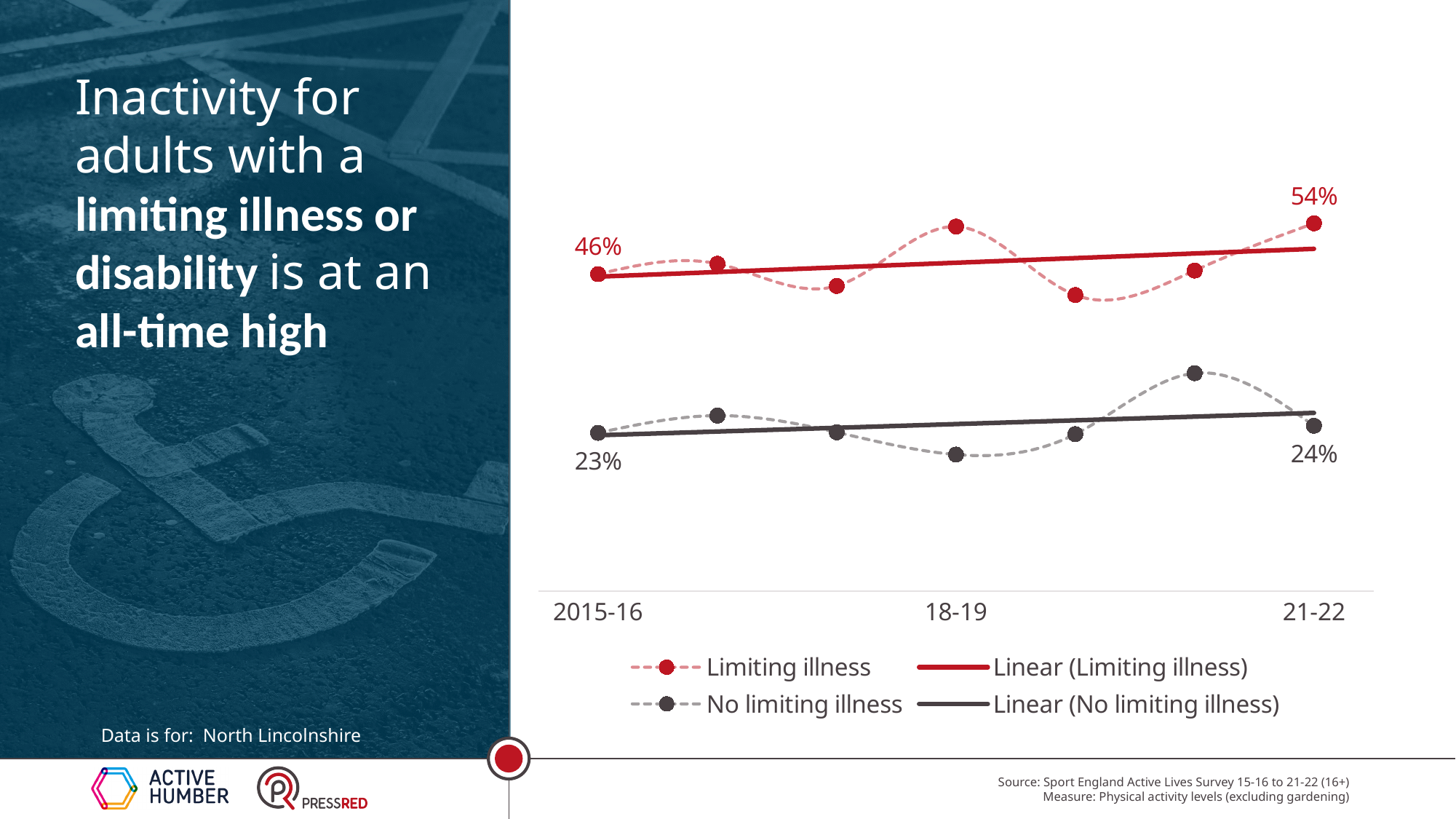
By how many percentage points did the Limiting illness value change from 2015-16 to 21-22? 8 percentage points In which year does the Limiting illness series reach its highest value? 21-22 What is the inactivity value for the Limiting illness series in 21-22? 54% What kind of chart is shown on the slide? Line chart How many data points are plotted for each series? 7 In 2015-16, which series has the higher value: Limiting illness or No limiting illness? Limiting illness What is the inactivity value for the No limiting illness series in 2015-16? 23% How many entries does the legend list? 4 In 21-22, what is the difference between the Limiting illness and No limiting illness values? 30 percentage points In which year does the No limiting illness series reach its lowest value? 18-19 What is the inactivity value for the Limiting illness series in 2015-16? 46% What is the inactivity value for the No limiting illness series in 21-22? 24%